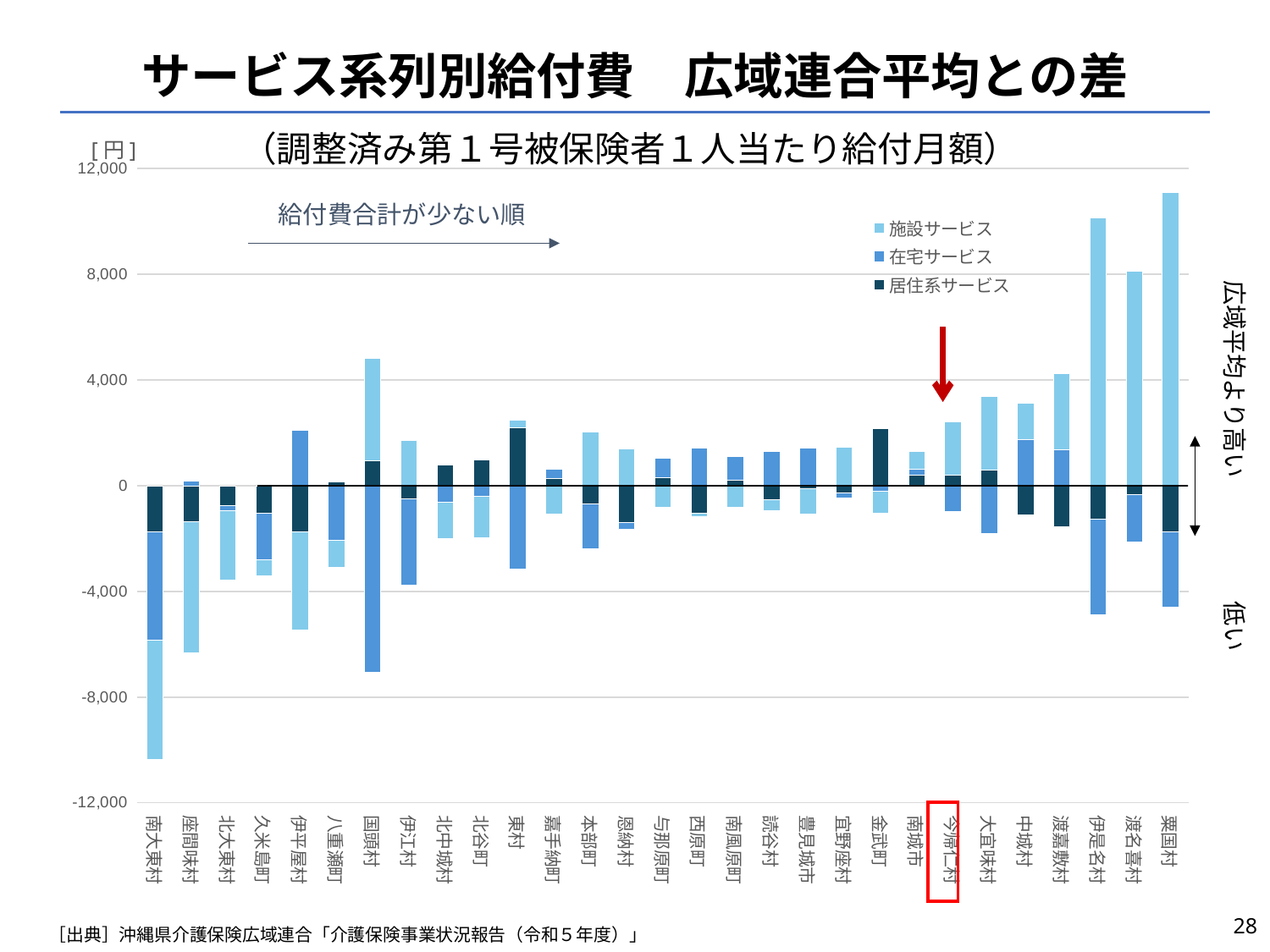
What unit is shown at the top of the y axis? 円 Is the bottom of the 国頭村 bar greater or less than -4,000? less Which has the taller bar above zero, 伊是名村 or 渡名喜村? 伊是名村 Which municipality's label is highlighted with a red box on the x axis? 今帰仁村 What kind of chart is shown on the slide? Bar chart How many municipalities (categories) are shown on the x axis? 29 Is the top of the 粟国村 bar greater or less than 8,000? greater Is the bottom of the 南大東村 bar greater or less than -8,000? less Which municipality has the bar extending furthest below zero? 南大東村 Which municipality has the tallest bar above zero? 粟国村 How many series does the legend list? 3